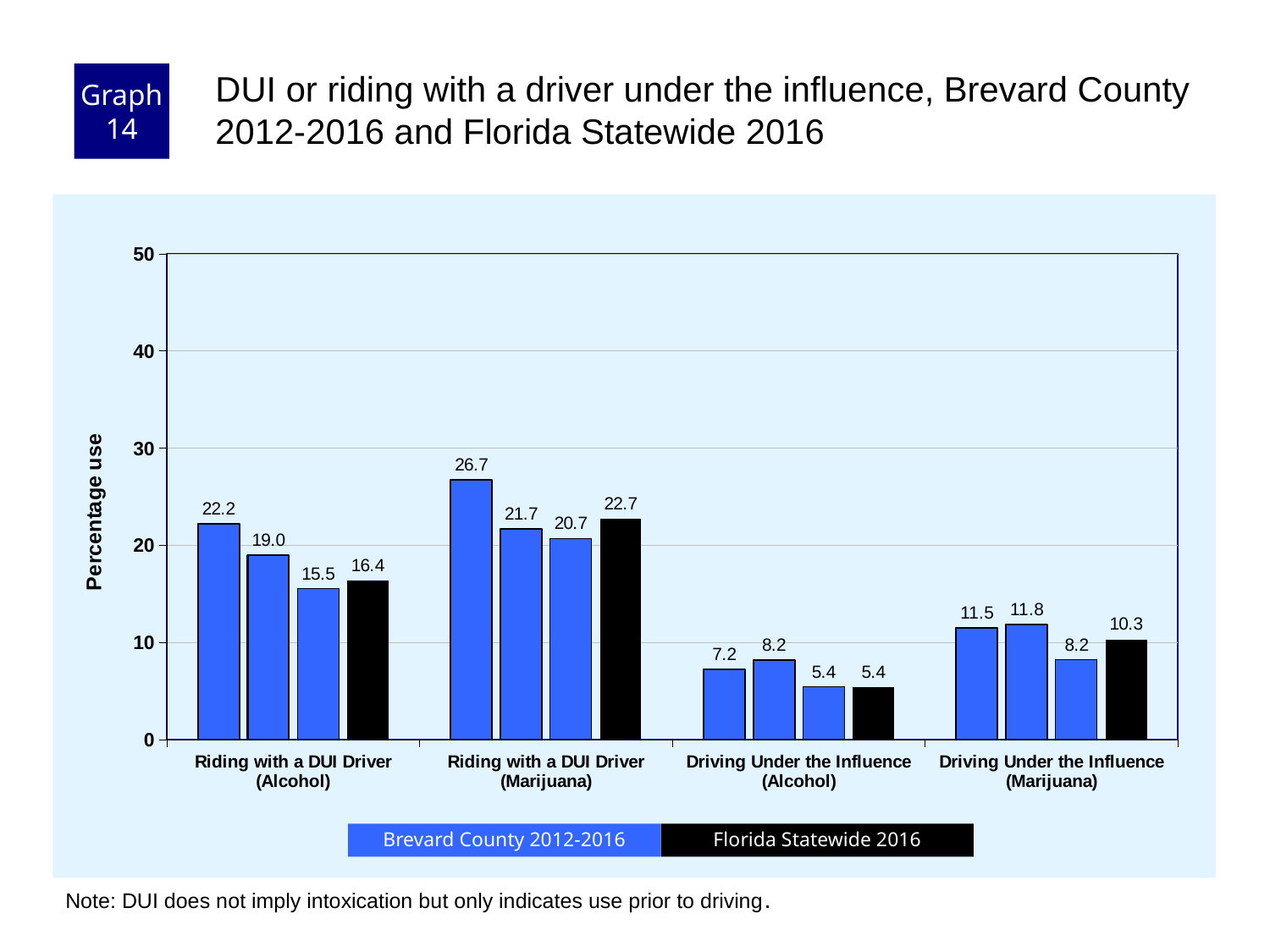
What is the Florida Statewide 2016 value for Riding with a DUI Driver (Marijuana)? 22.7 Which category has the highest Florida Statewide 2016 value? Riding with a DUI Driver (Marijuana) How many series does the legend list? 2 What is the label of the y axis? Percentage use What is the Florida Statewide 2016 value for Driving Under the Influence (Marijuana)? 10.3 What is the difference between the Florida Statewide 2016 values for Riding with a DUI Driver (Marijuana) and Riding with a DUI Driver (Alcohol)? 6.3 What is the value of the first (leftmost) Brevard County bar for Riding with a DUI Driver (Marijuana)? 26.7 Which category has the lowest Florida Statewide 2016 value? Driving Under the Influence (Alcohol) What kind of chart is shown on the slide? Bar chart Which is larger: the Florida Statewide 2016 value for Driving Under the Influence (Marijuana) or for Driving Under the Influence (Alcohol)? Driving Under the Influence (Marijuana) What is the Florida Statewide 2016 value for Riding with a DUI Driver (Alcohol)? 16.4 How many categories are shown on the x axis? 4